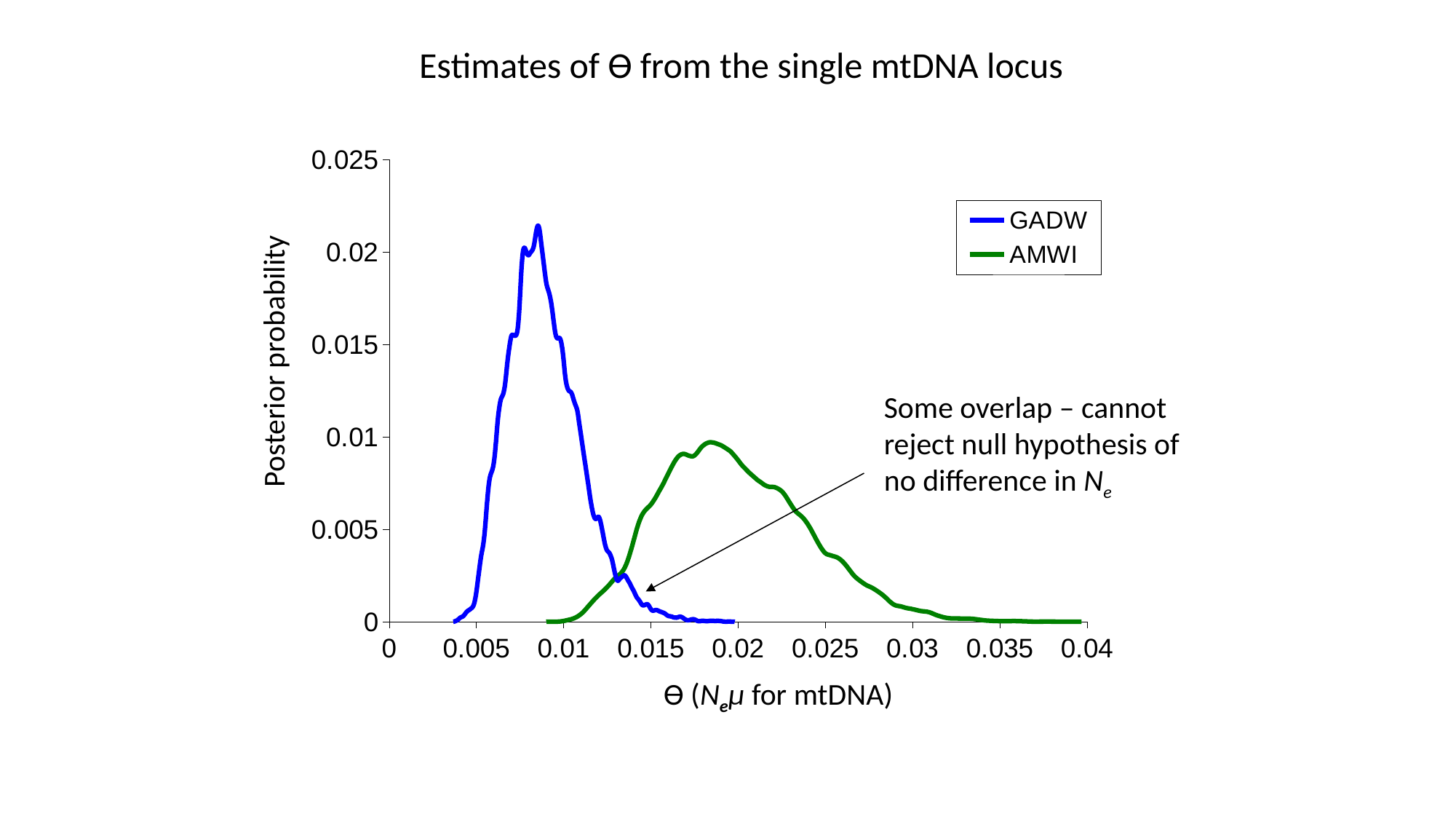
What is the label on the y axis of the chart? Posterior probability How many tick labels are shown on the x axis? 9 Is the peak posterior probability for AMWI greater or less than 0.015? less Is the peak posterior probability for GADW greater or less than 0.015? greater Which series has the lower peak posterior probability? AMWI Is the peak posterior probability for AMWI greater or less than 0.005? greater Which series peaks at a larger value of Θ, GADW or AMWI? AMWI How many series does the legend list? 2 What kind of chart is shown on the slide? line chart Which series reaches the higher peak posterior probability? GADW What is the title of the chart? Estimates of Θ from the single mtDNA locus